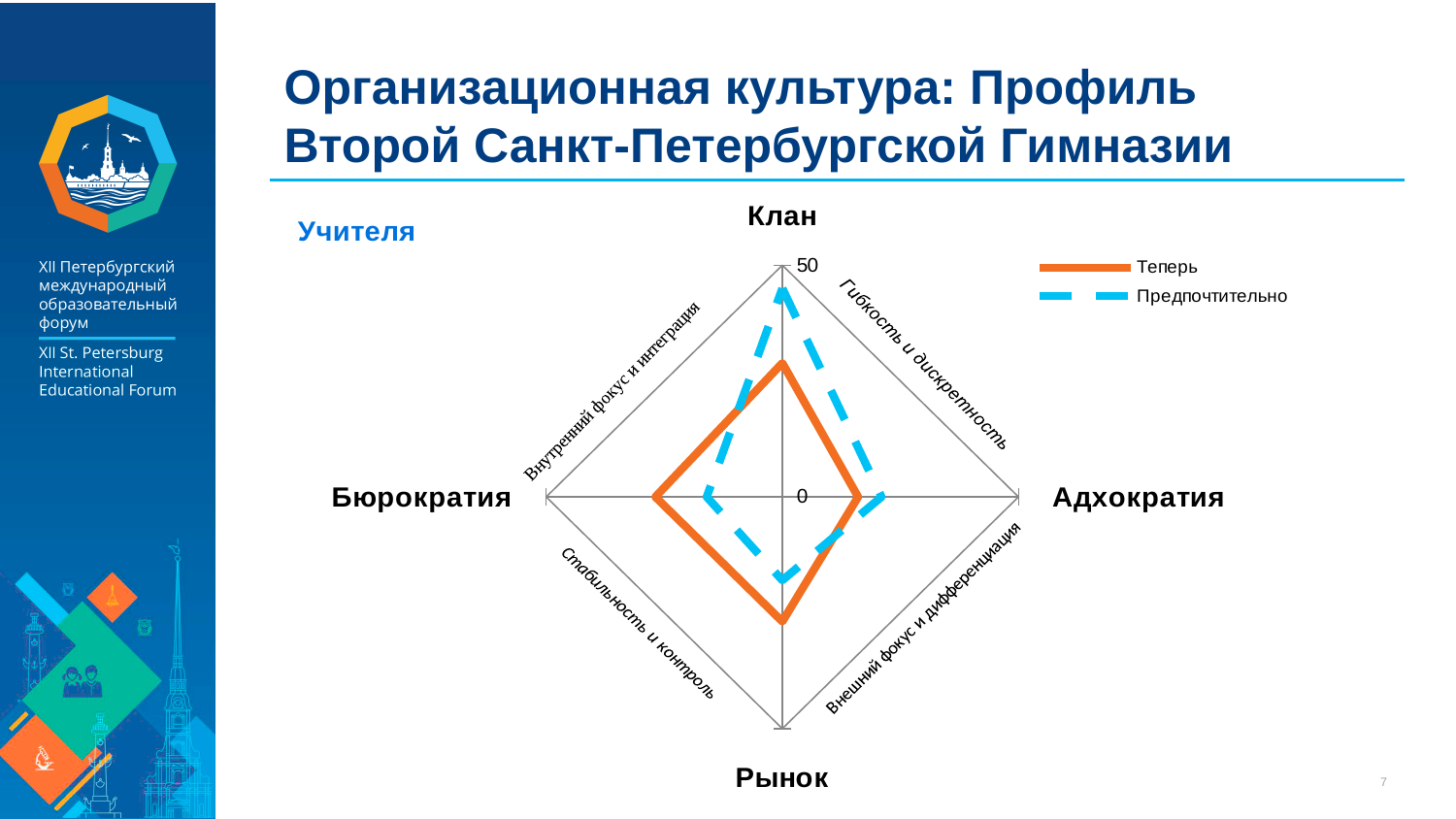
How many categories (axes) does the radar chart have? 4 For the Теперь series, which category has the lowest value? Адхократия Is the Теперь value for Адхократия greater or less than 50? less For Бюрократия, which series has the larger value, Теперь or Предпочтительно? Теперь Which series is drawn with a dashed line? Предпочтительно For Клан, which series has the larger value, Теперь or Предпочтительно? Предпочтительно For Рынок, which series has the larger value, Теперь or Предпочтительно? Теперь What kind of chart is shown on the slide? radar chart Is the Предпочтительно value for Клан greater or less than 50? less For the Предпочтительно series, which category has the highest value? Клан What is the maximum value shown on the chart's axis scale? 50 How many series does the legend list? 2